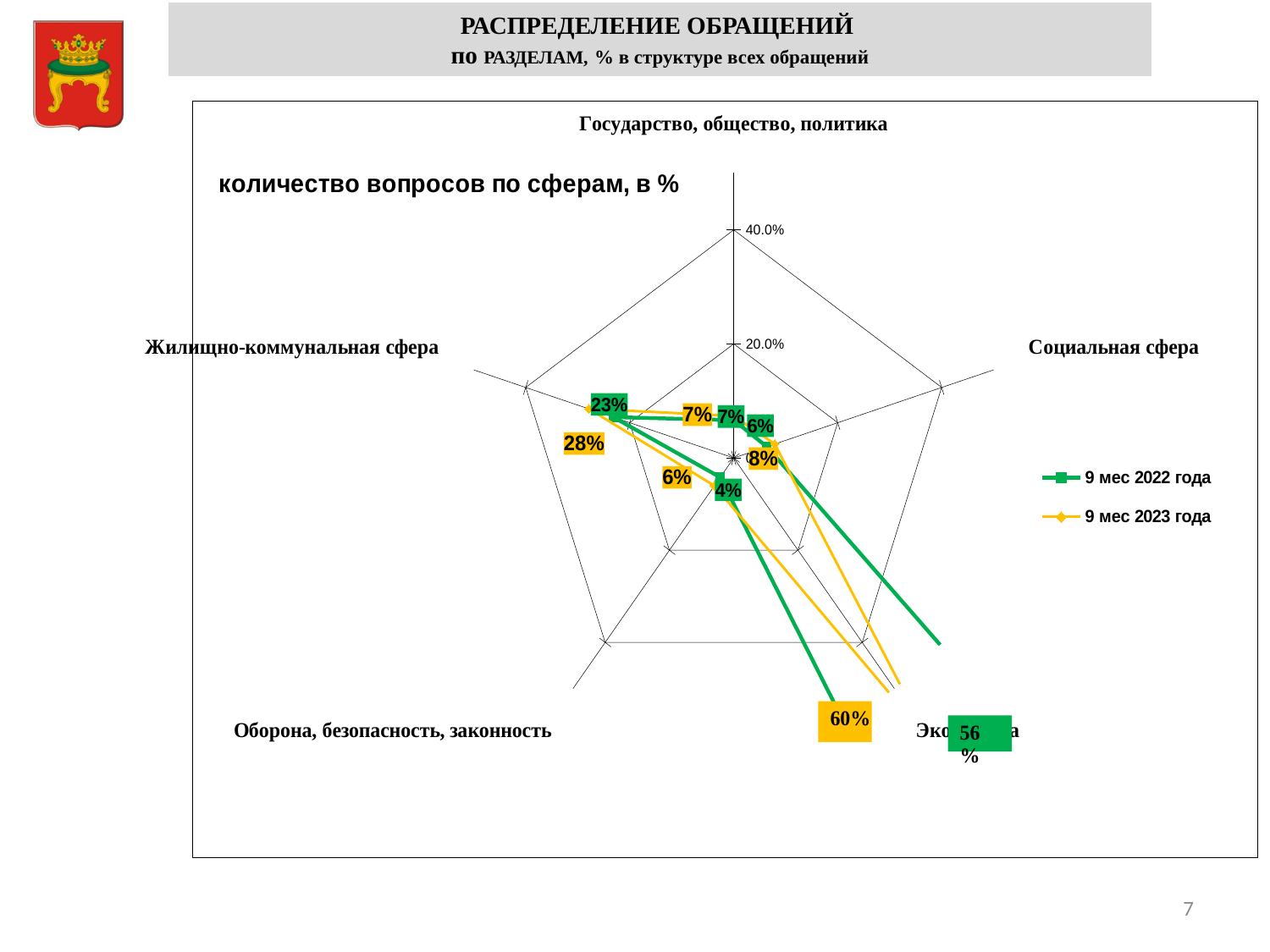
How many categories (axes) does the radar chart have? 5 What are the two entries in the chart legend? 9 мес 2022 года and 9 мес 2023 года For Социальная сфера, which series has the larger value, 9 мес 2022 года or 9 мес 2023 года? 9 мес 2023 года What is the value for Социальная сфера in the 9 мес 2023 года series? 8% What is the value for Государство, общество, политика in the 9 мес 2023 года series? 7% By how many percentage points does the 9 мес 2023 года value for Жилищно-коммунальная сфера exceed the 9 мес 2022 года value? 5 What is the value for Оборона, безопасность, законность in the 9 мес 2022 года series? 4% How many series does the legend list? 2 What kind of chart is shown on the slide? Radar chart What is the value for Жилищно-коммунальная сфера in the 9 мес 2022 года series? 23% What is the value for Жилищно-коммунальная сфера in the 9 мес 2023 года series? 28%